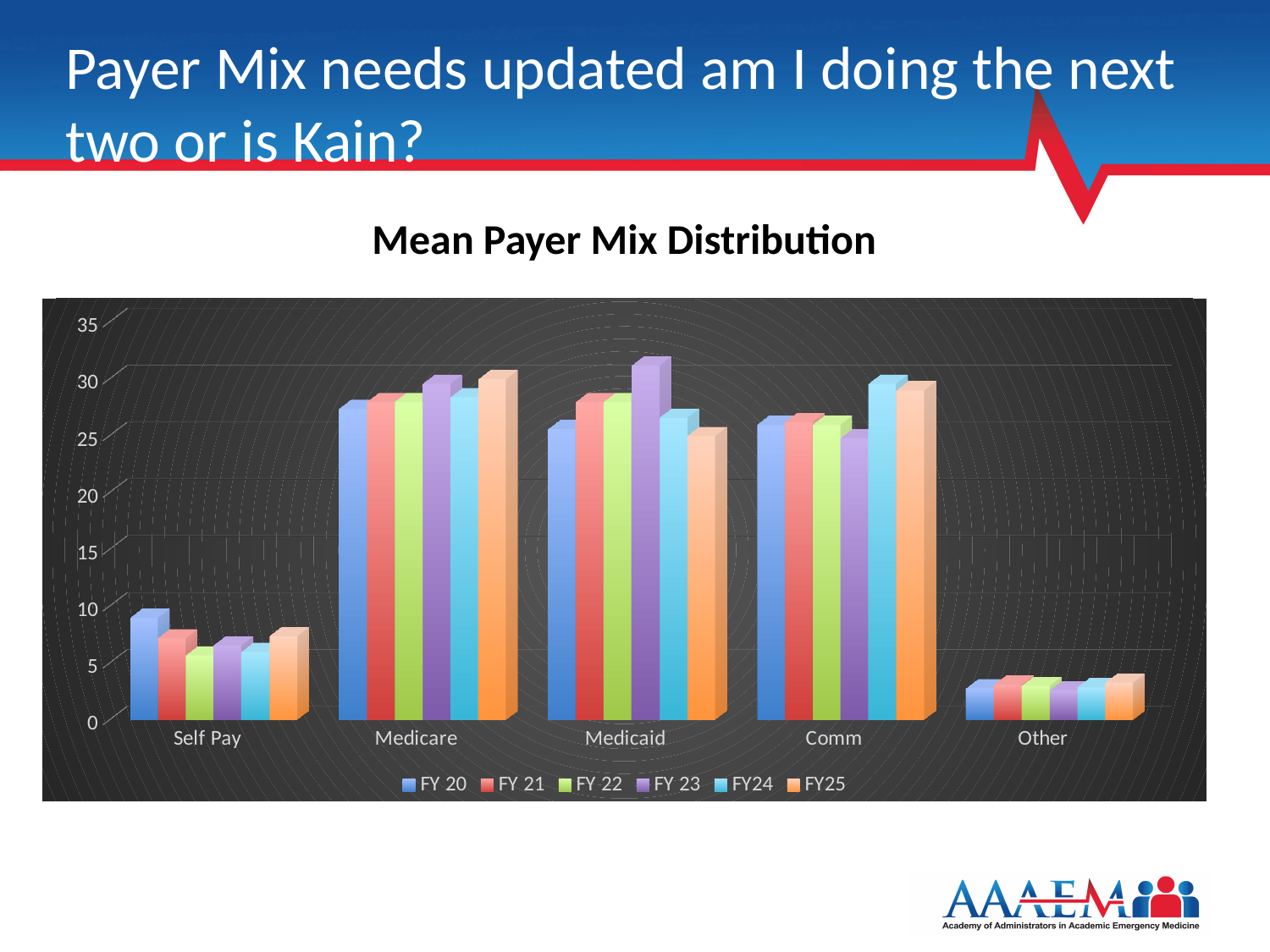
How many series does the legend list? 6 What is the title of the chart? Mean Payer Mix Distribution Which payer category has the lowest values across all fiscal years? Other How many payer categories are shown on the x axis? 5 Which is larger: the FY 23 value for Medicaid or the FY 23 value for Comm? Medicaid What type of chart is shown on the slide? Bar chart Within the Medicaid category, which fiscal year has the highest bar? FY 23 Is the FY 20 value for Self Pay greater or less than 10? less Within the Self Pay category, which fiscal year has the highest bar? FY 20 Is the FY25 value for Other greater or less than 5? less Is the FY 23 value for Medicaid greater or less than 30? greater